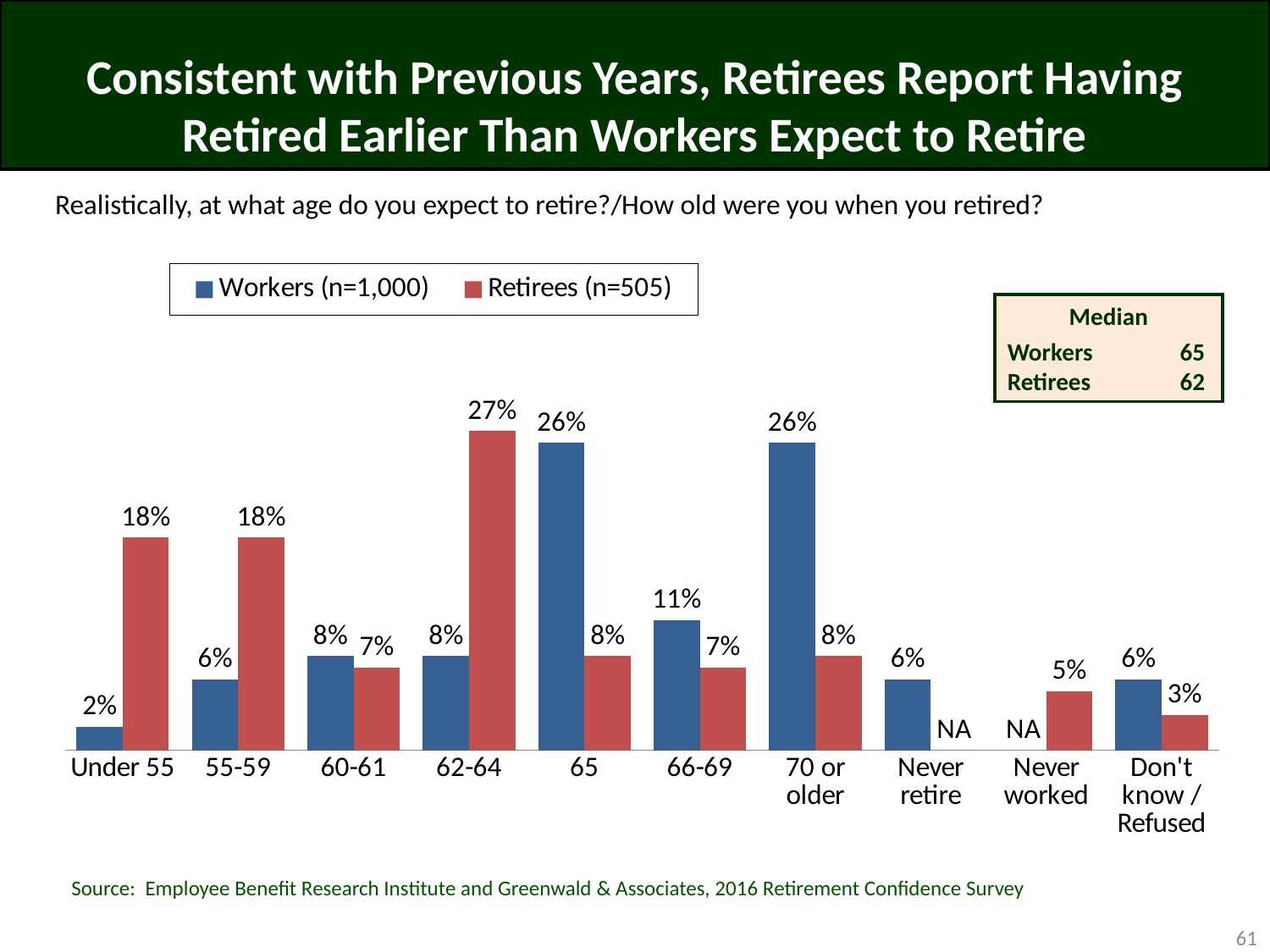
What is the difference between the Retirees and Workers values for the 62-64 category? 19 percentage points What percentage of Retirees retired at age 62-64? 27% What percentage of Workers expect to retire at 65? 26% What percentage of Retirees retired under age 55? 18% Which age category has the highest value for Retirees? 62-64 Which category has the lowest value for Workers? Under 55 How many series does the legend list? 2 What is the median expected retirement age for Workers shown in the box? 65 How many categories are shown on the x axis? 10 What percentage of Workers expect to never retire? 6% What kind of chart is shown on the slide? Bar chart Which is larger for the 70 or older category, the Workers value or the Retirees value? Workers